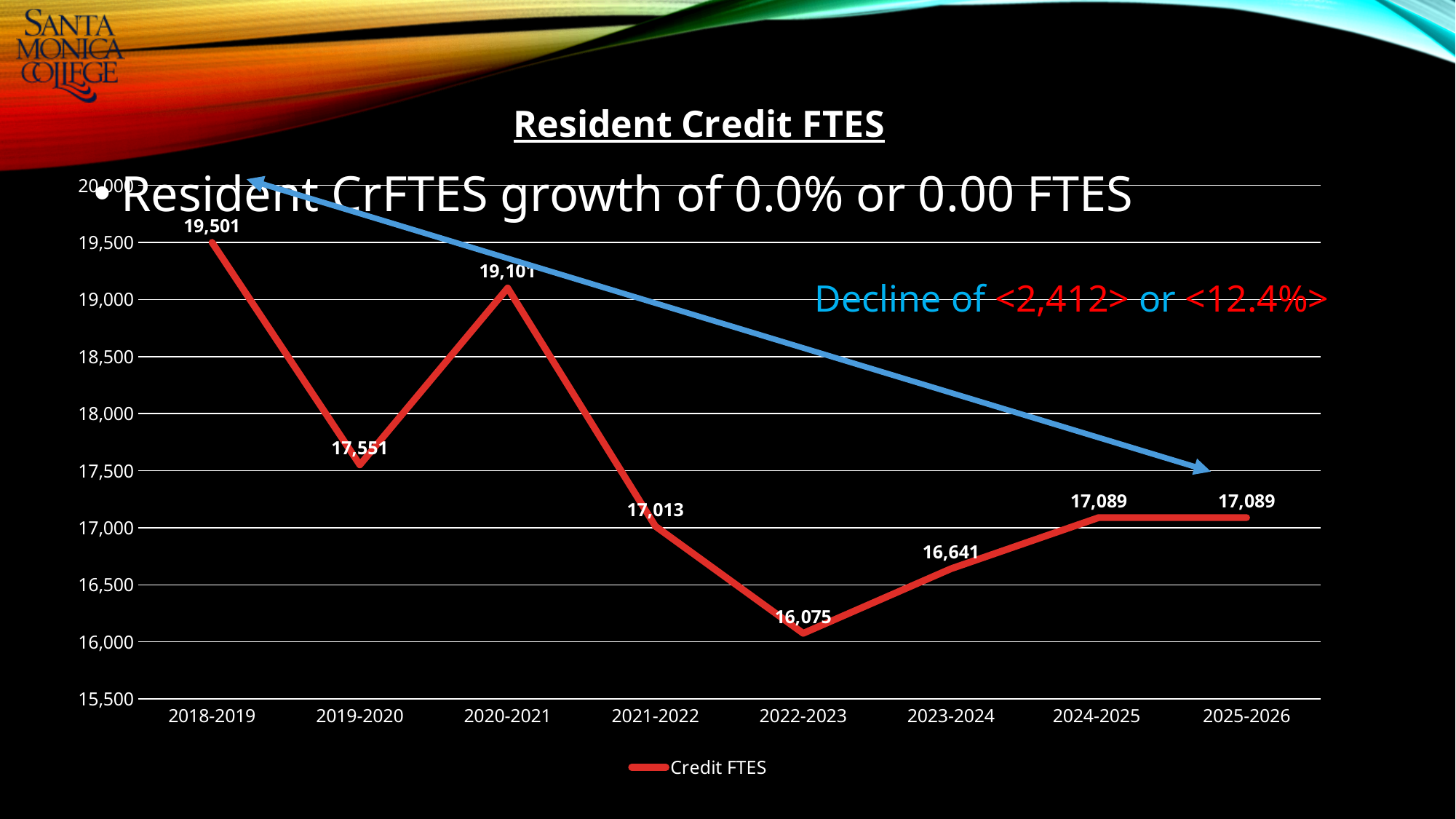
What is the Credit FTES value for 2022-2023? 16,075 What is the difference in Credit FTES between 2018-2019 and 2019-2020? 1,950 What is the title of the chart? Resident Credit FTES What is the Credit FTES value for 2018-2019? 19,501 Which year has the highest Credit FTES? 2018-2019 Which is larger, the Credit FTES for 2019-2020 or for 2021-2022? 2019-2020 What is the Credit FTES value for 2020-2021? 19,101 What is the difference in Credit FTES between 2024-2025 and 2023-2024? 448 What kind of chart is shown? line chart Which year has the lowest Credit FTES? 2022-2023 How many years are plotted on the x axis? 8 How many series does the legend list? 1